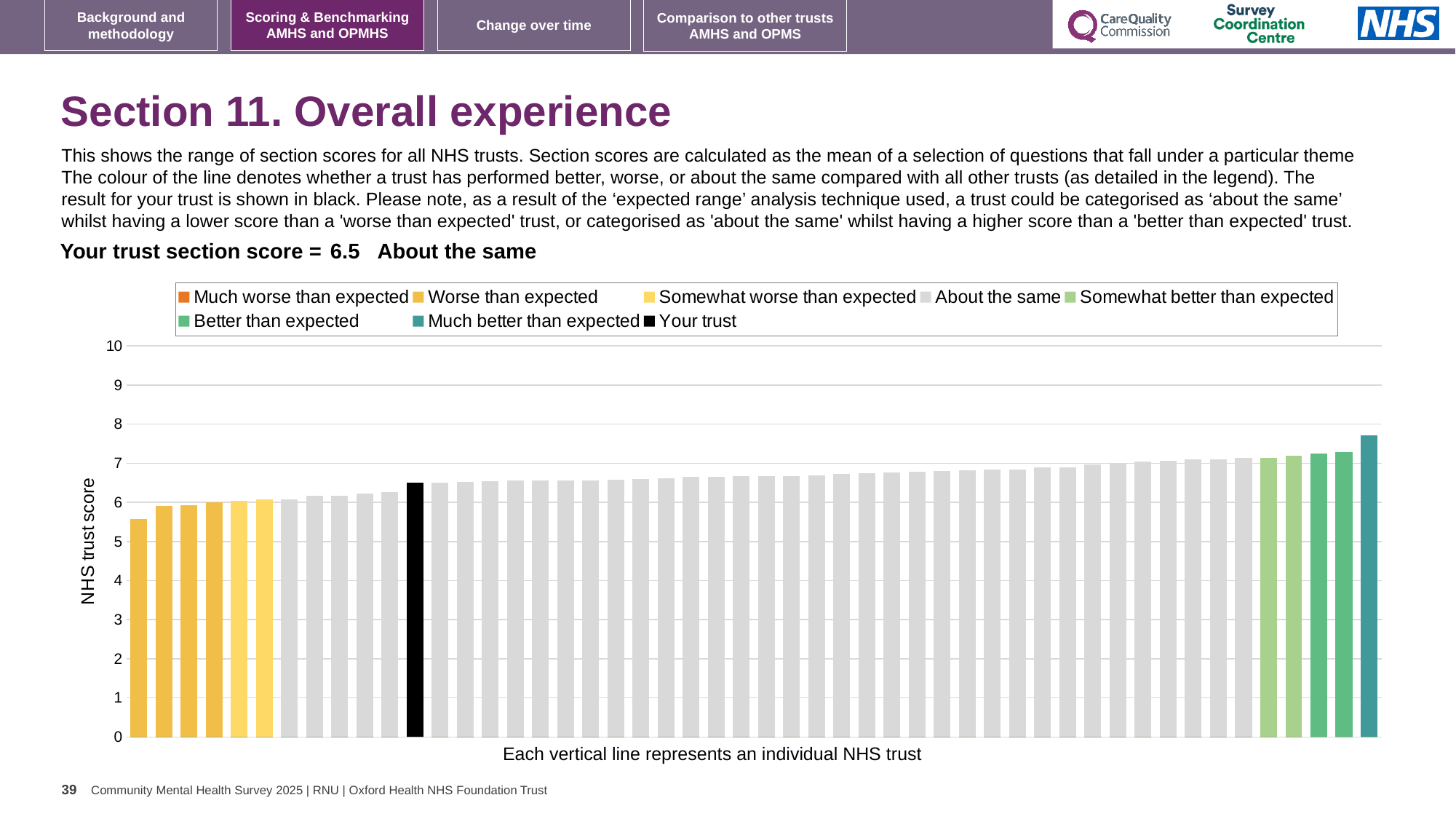
Is the value for your trust greater or less than 6? greater What is the section score for your trust shown on the slide? 6.5 How many bars are coloured as 'Worse than expected'? 4 How many bars are coloured as 'Much better than expected'? 1 Do the bar values rise or fall from left to right along the x axis? rise Is the value of the tallest bar (the 'Much better than expected' trust) greater or less than 7? greater How many entries does the chart legend list? 8 Is the value of the shortest bar (the leftmost trust) greater or less than 6? less What is the x-axis label of the chart? Each vertical line represents an individual NHS trust How many bars are coloured as 'Better than expected'? 2 What colour is the bar representing your trust? black What kind of chart is shown on the slide? bar chart